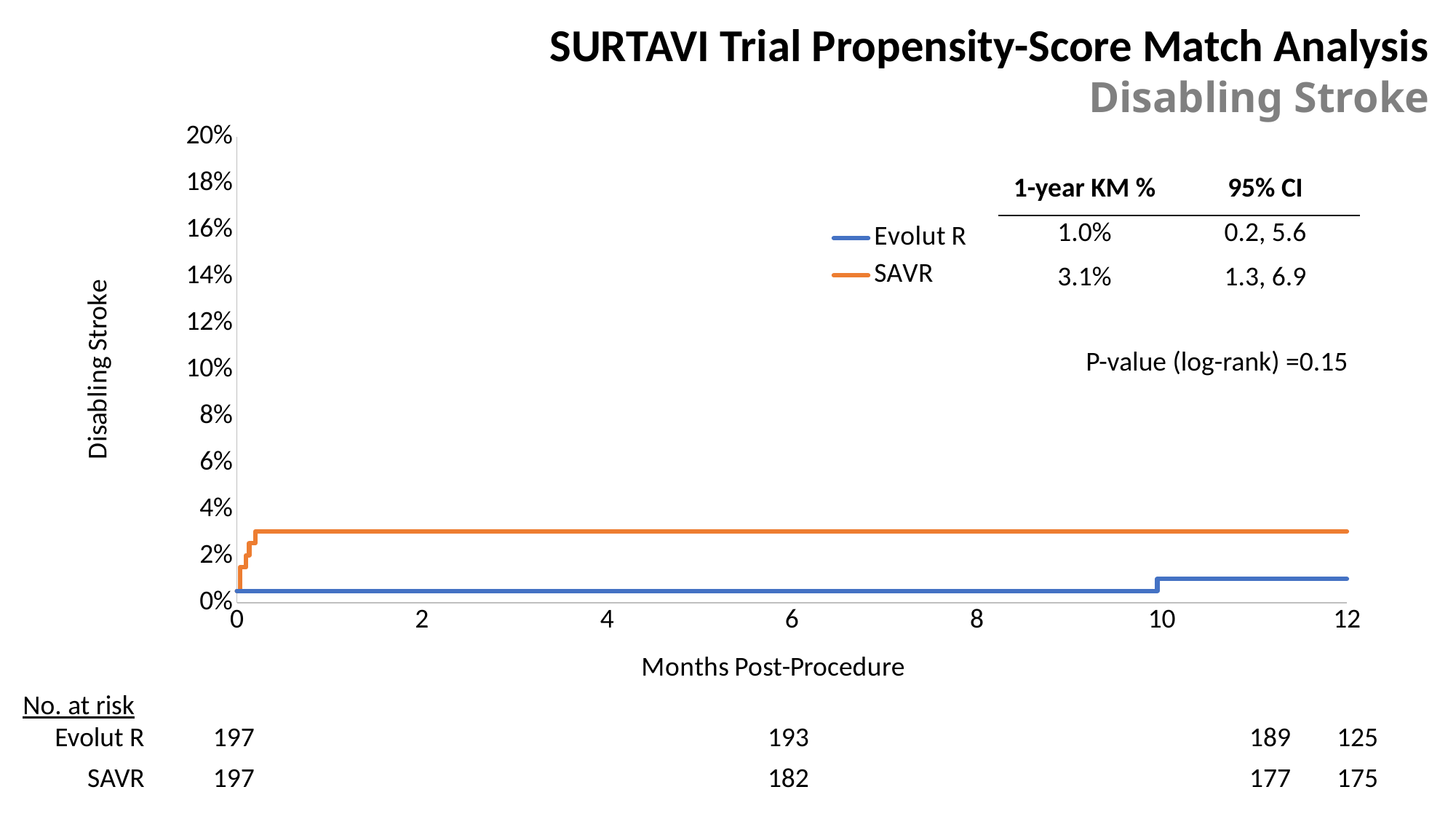
What is the difference between the 1-year KM % for SAVR and for Evolut R? 2.1 percentage points What is the 1-year KM % for SAVR? 3.1% What is the number at risk for SAVR at the last time point (12 months)? 175 What is the 95% CI for the 1-year KM % of SAVR? 1.3, 6.9 At 6 months post-procedure, is the disabling stroke rate for Evolut R greater or less than 2%? less What is the 1-year KM % for Evolut R? 1.0% Which series has the higher 1-year KM % for disabling stroke? SAVR What is the label of the x axis? Months Post-Procedure At 6 months post-procedure, is the disabling stroke rate for SAVR greater or less than 4%? less What is the log-rank P-value shown on the chart? 0.15 What kind of chart is shown on the slide? Line chart How many series does the legend list? 2